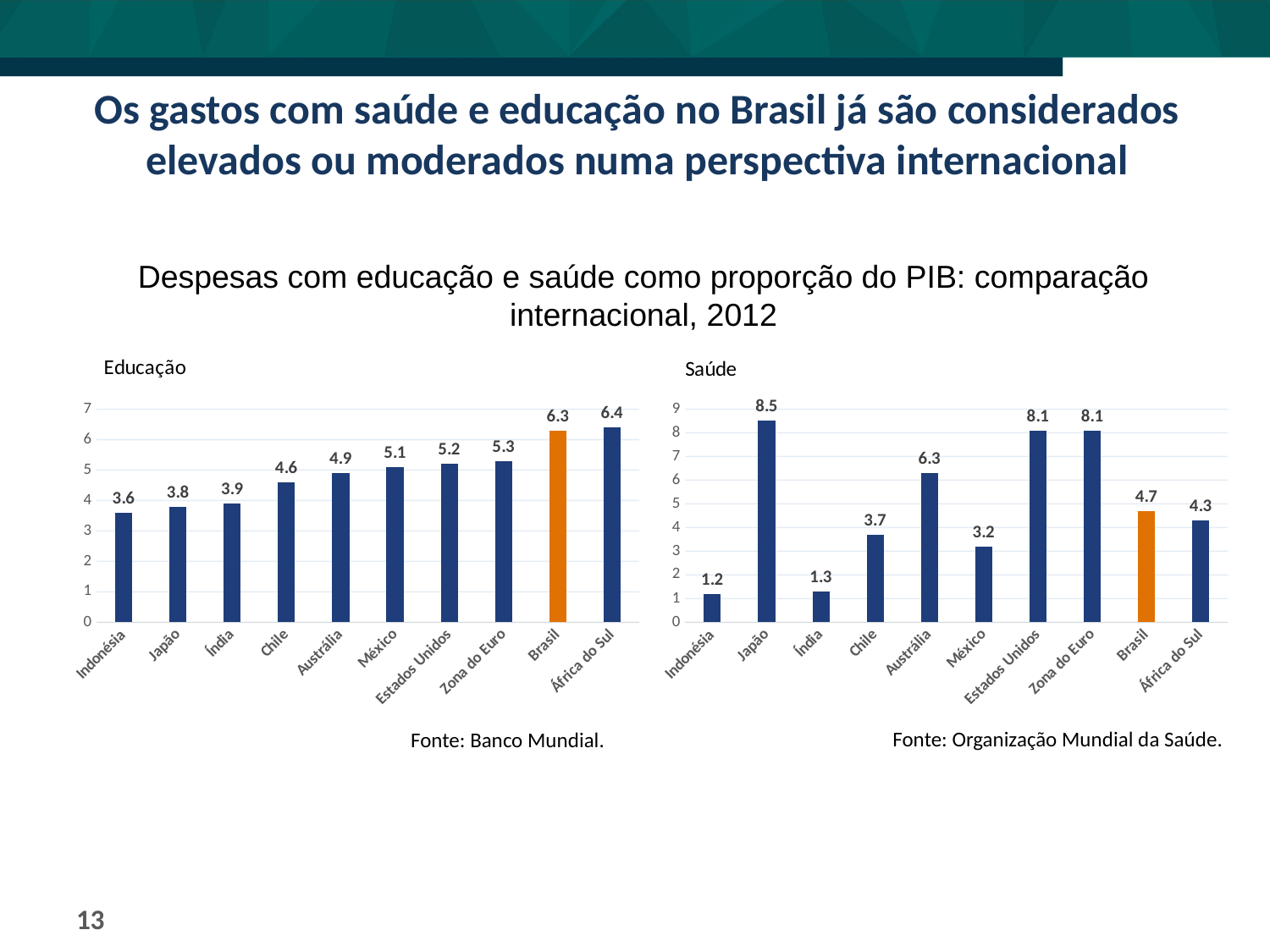
In the Saúde chart, is the value for Austrália greater or less than 5? greater In the Saúde chart, which country has the lowest value? Indonésia In the Educação chart, what is the value for Brasil? 6.3 In the Saúde chart, what is the difference between Japão and Brasil? 3.8 In the Saúde chart, what is the value for Japão? 8.5 In the Educação chart, do the values rise or fall from Indonésia to África do Sul? rise In the Educação chart, which is larger, the value for Chile or the value for México? México In the Saúde chart, what is the value for Índia? 1.3 How many countries or regions are shown in the Educação chart? 10 What type of chart is the Saúde chart? bar chart In the Educação chart, which bar is coloured orange? Brasil In the Educação chart, which country has the highest value? África do Sul